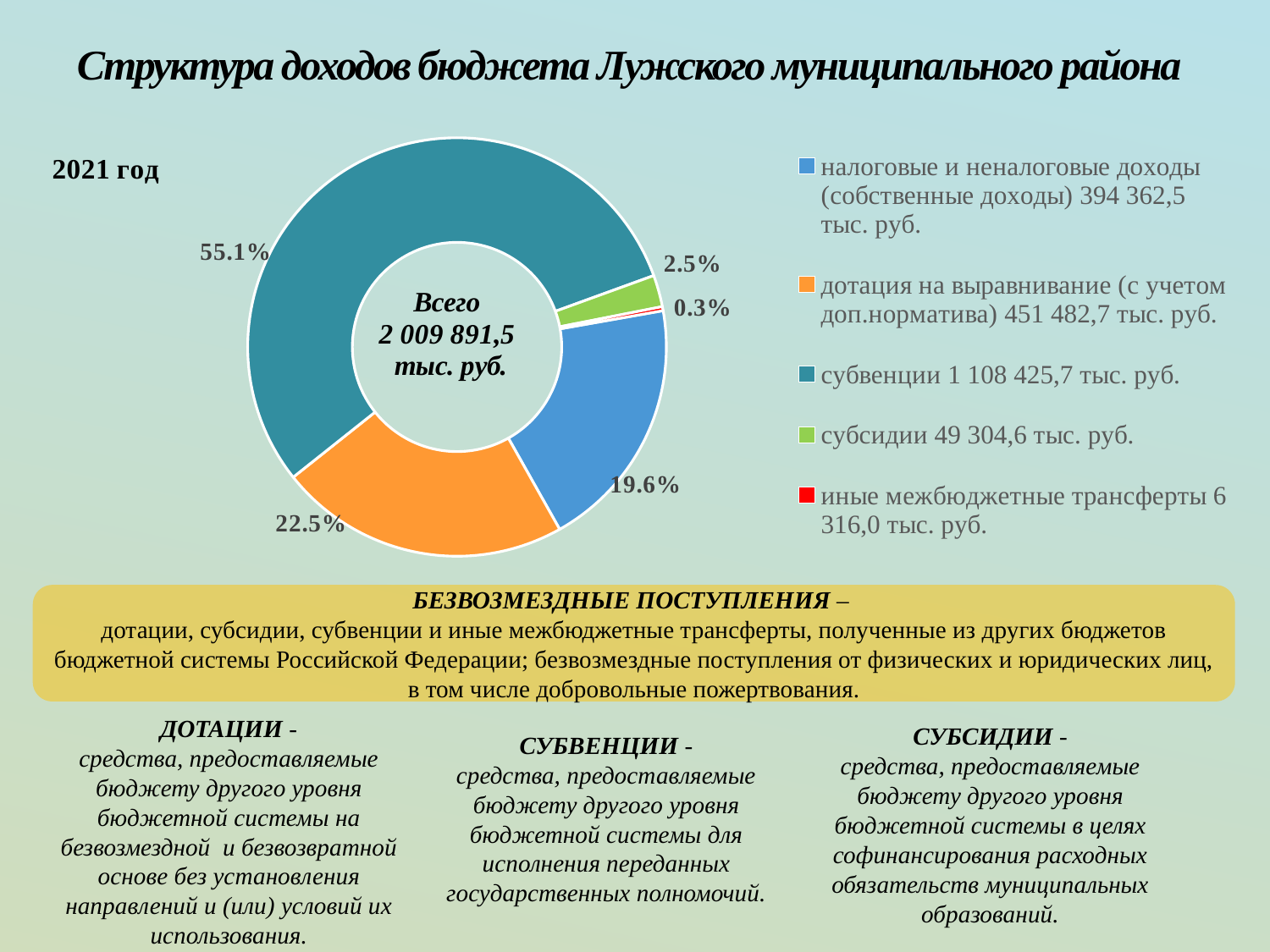
What share of the budget revenue is shown for субсидии? 2.5% What is the total budget revenue shown in the centre of the chart? 2 009 891,5 тыс. руб. What share of the budget revenue is shown for иные межбюджетные трансферты? 0.3% What kind of chart is shown on the slide? doughnut (pie) chart Which category has the largest share of the budget revenue? субвенции Which year does the chart refer to? 2021 год What share of the budget revenue is shown for налоговые и неналоговые доходы (собственные доходы)? 19.6% What is the difference in percentage points between the share for субвенции and the share for дотация на выравнивание? 32.6 How many categories does the legend list? 5 Which category has the smallest share of the budget revenue? иные межбюджетные трансферты